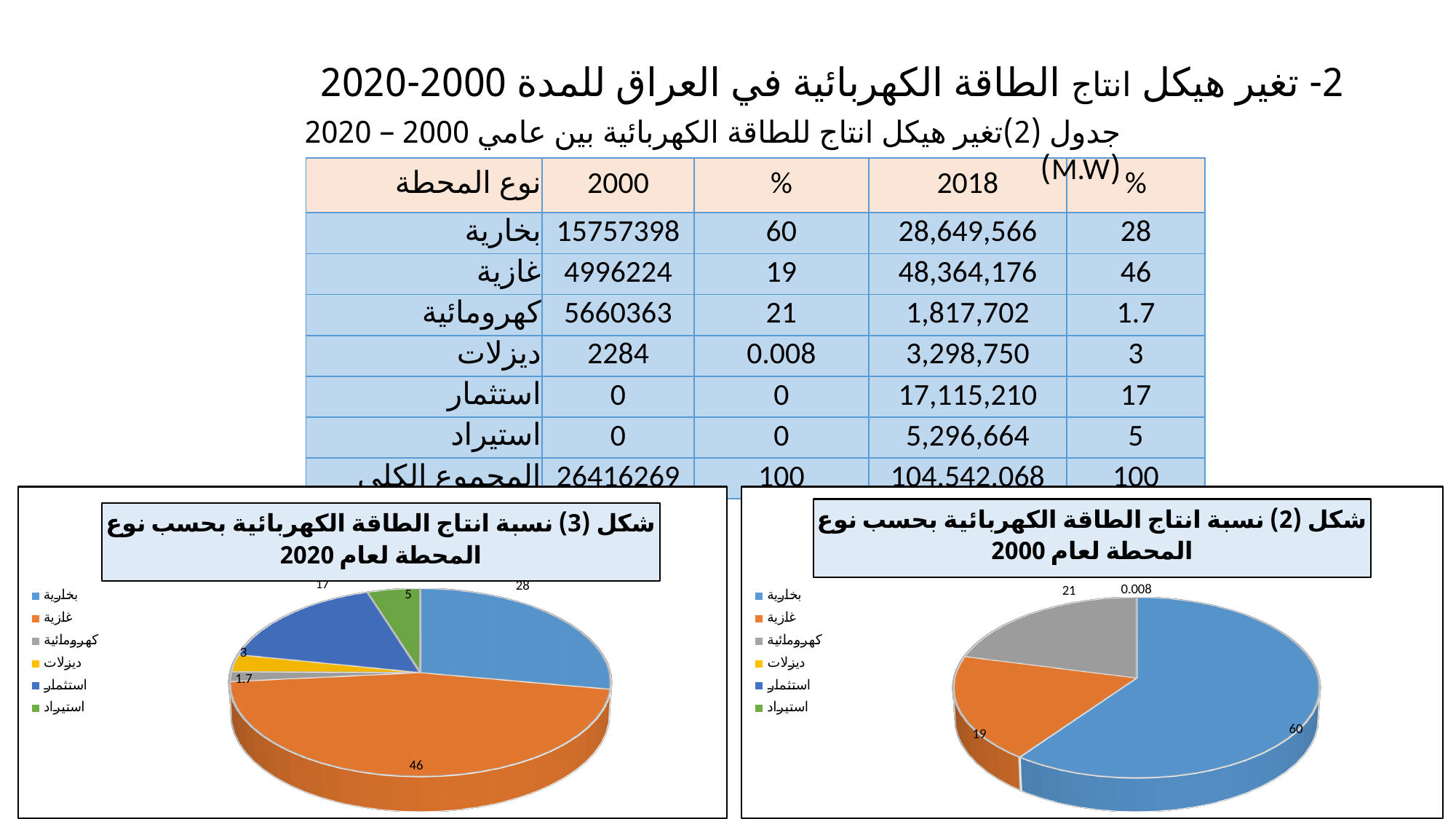
In the left pie chart (شكل 3, year 2020), what is the value labelled for استيراد? 5 How many entries does the legend of the left pie chart (شكل 3, year 2020) list? 6 In the right pie chart (شكل 2, year 2000), what is the value labelled on the orange slice for غازية? 19 In the right pie chart (شكل 2, year 2000), which category has the largest slice? بخارية In the left pie chart (شكل 3, year 2020), what is the value labelled on the orange slice for غازية? 46 In the right pie chart (شكل 2, year 2000), what is the value labelled on the blue slice for بخارية? 60 In the right pie chart (شكل 2, year 2000), what is the difference between the بخارية value and the كهرومائية value? 39 In the left pie chart (شكل 3, year 2020), which is larger, the slice for بخارية or the slice for غازية? غازية In the left pie chart (شكل 3, year 2020), what is the value labelled for استثمار? 17 In the right pie chart (شكل 2, year 2000), what is the value labelled for كهرومائية? 21 What type of chart is شكل (2) on the right of the slide? pie chart In the left pie chart (شكل 3, year 2020), which category has the smallest slice? كهرومائية